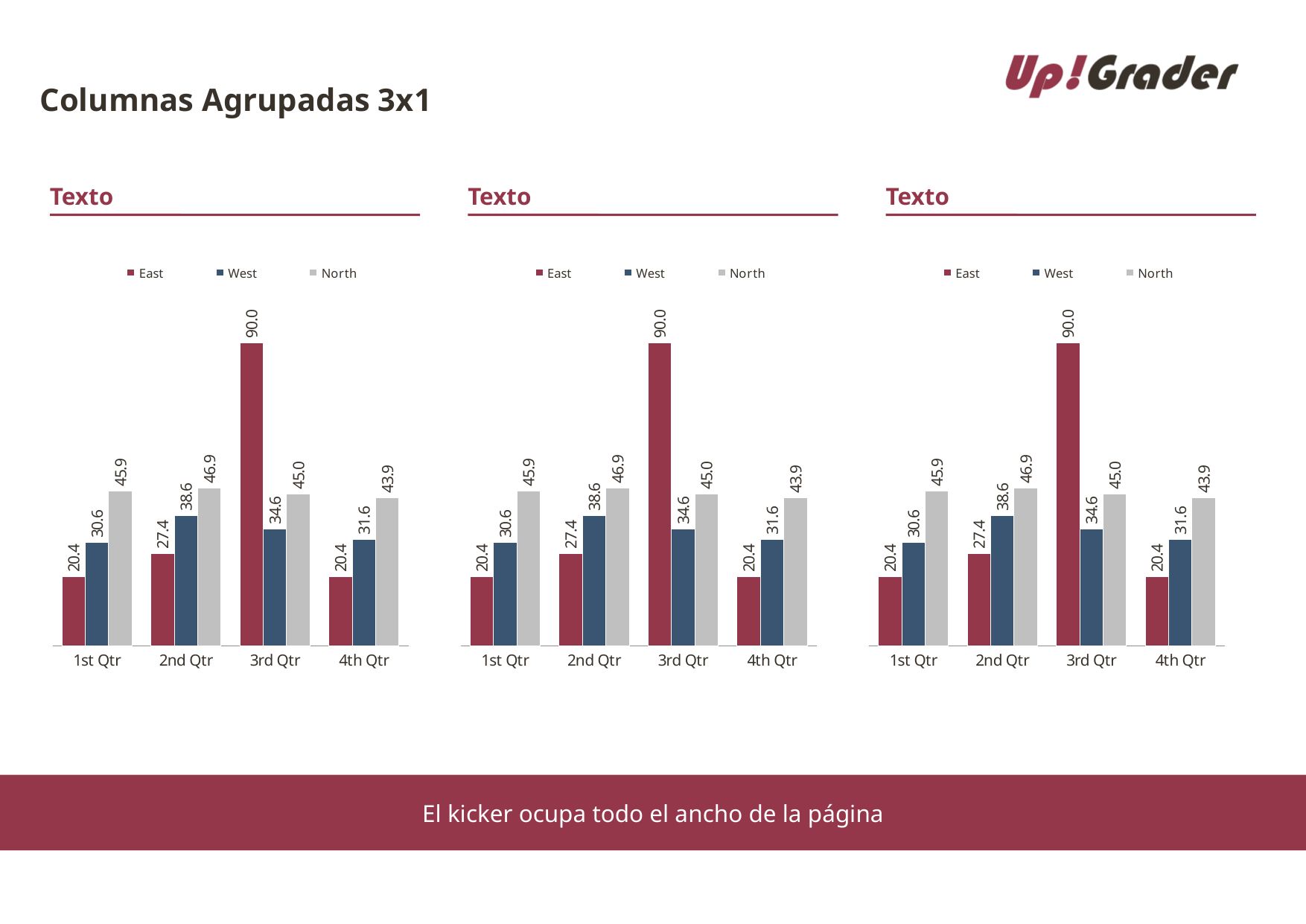
What kind of chart is the left chart? Bar chart In the right chart, what is the value for North in 4th Qtr? 43.9 In the left chart, which series is shown in grey in the legend? North In the middle chart, what is the difference between the North value and the East value in 1st Qtr? 25.5 In the middle chart, what is the value for West in 2nd Qtr? 38.6 In the left chart, what is the value for East in 3rd Qtr? 90.0 In the middle chart, which quarter has the lowest value for West? 1st Qtr In the middle chart, how many quarters are shown on the x axis? 4 In the right chart, what is the difference between the East value in 3rd Qtr and the East value in 2nd Qtr? 62.6 In the right chart, how many series does the legend list? 3 In the left chart, which is larger in 4th Qtr: West or North? North In the left chart, which quarter has the highest value for North? 2nd Qtr